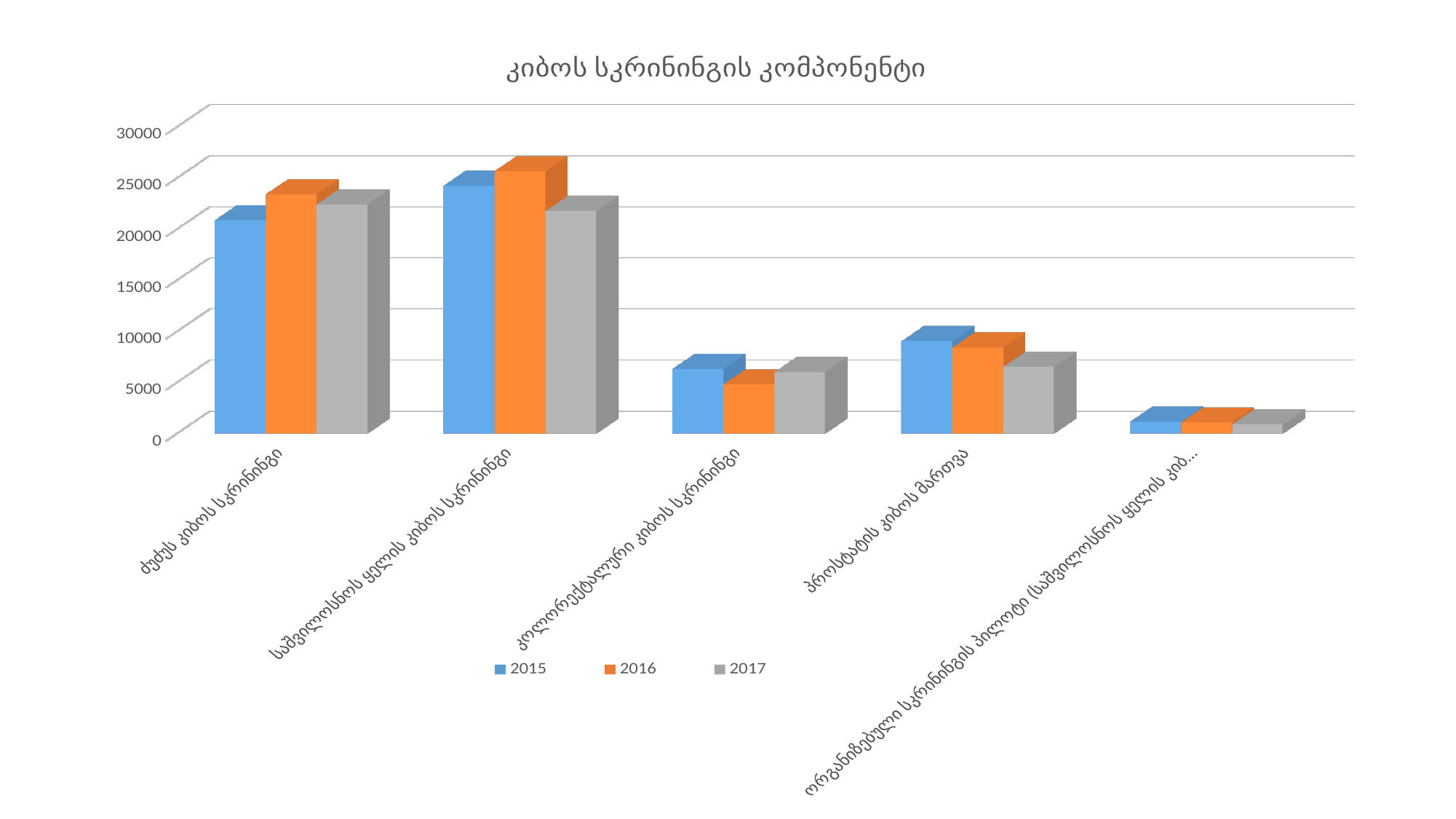
What kind of chart is shown on the slide? bar chart How many categories are shown on the x axis? 5 For ძუძუს კიბოს სკრინინგი, which series has the larger value, 2015 or 2016? 2016 Is the 2016 value for ძუძუს კიბოს სკრინინგი greater or less than 20000? greater For საშვილოსნოს ყელის კიბოს სკრინინგი, which series has the larger value, 2016 or 2017? 2016 What is the title of the chart? კიბოს სკრინინგის კომპონენტი Is the 2015 value for კოლორექტალური კიბოს სკრინინგი greater or less than 5000? greater Which category has the lowest value for the 2015 series? ორგანიზებული სკრინინგის პილოტი (საშვილოსნოს ყელის კიბ... Is the 2015 value for პროსტატის კიბოს მართვა greater or less than 10000? less How many series does the legend list? 3 Which series is shown in orange in the legend? 2016 Which category has the highest value for the 2016 series? საშვილოსნოს ყელის კიბოს სკრინინგი